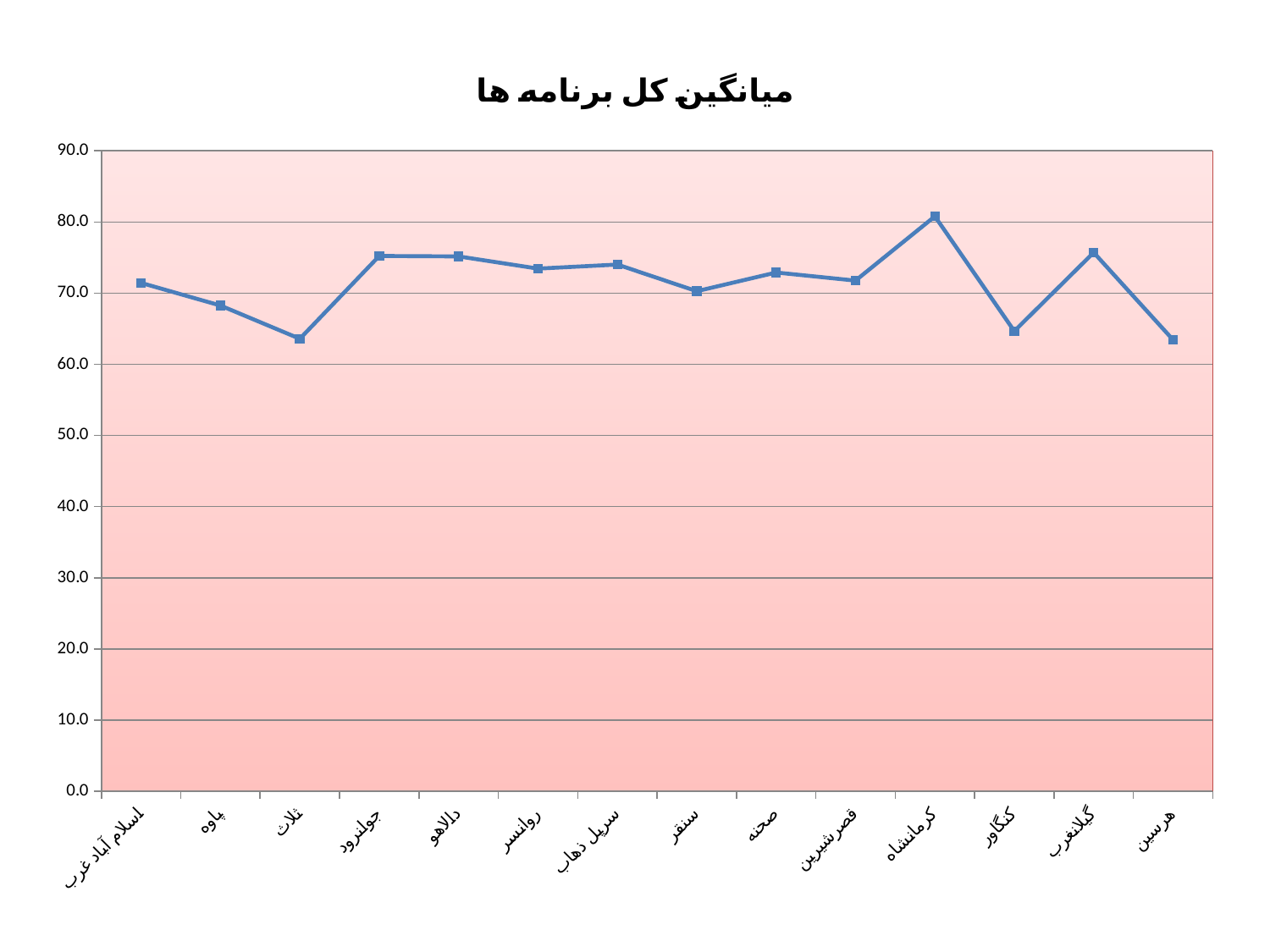
Is the value for ثلاث greater or less than 70? less How many categories are plotted along the x axis? 14 Is the value for کرمانشاه greater or less than 70? greater Is the value for جوانرود greater or less than 70? greater Which is larger, the value for پاوه or the value for ثلاث? پاوه Does the line rise or fall from کرمانشاه to کنگاور? fall What kind of chart is shown on the slide? line chart What is the title of the chart? میانگین کل برنامه ها Which category has the highest value? کرمانشاه Which is larger, the value for کرمانشاه or the value for کنگاور? کرمانشاه